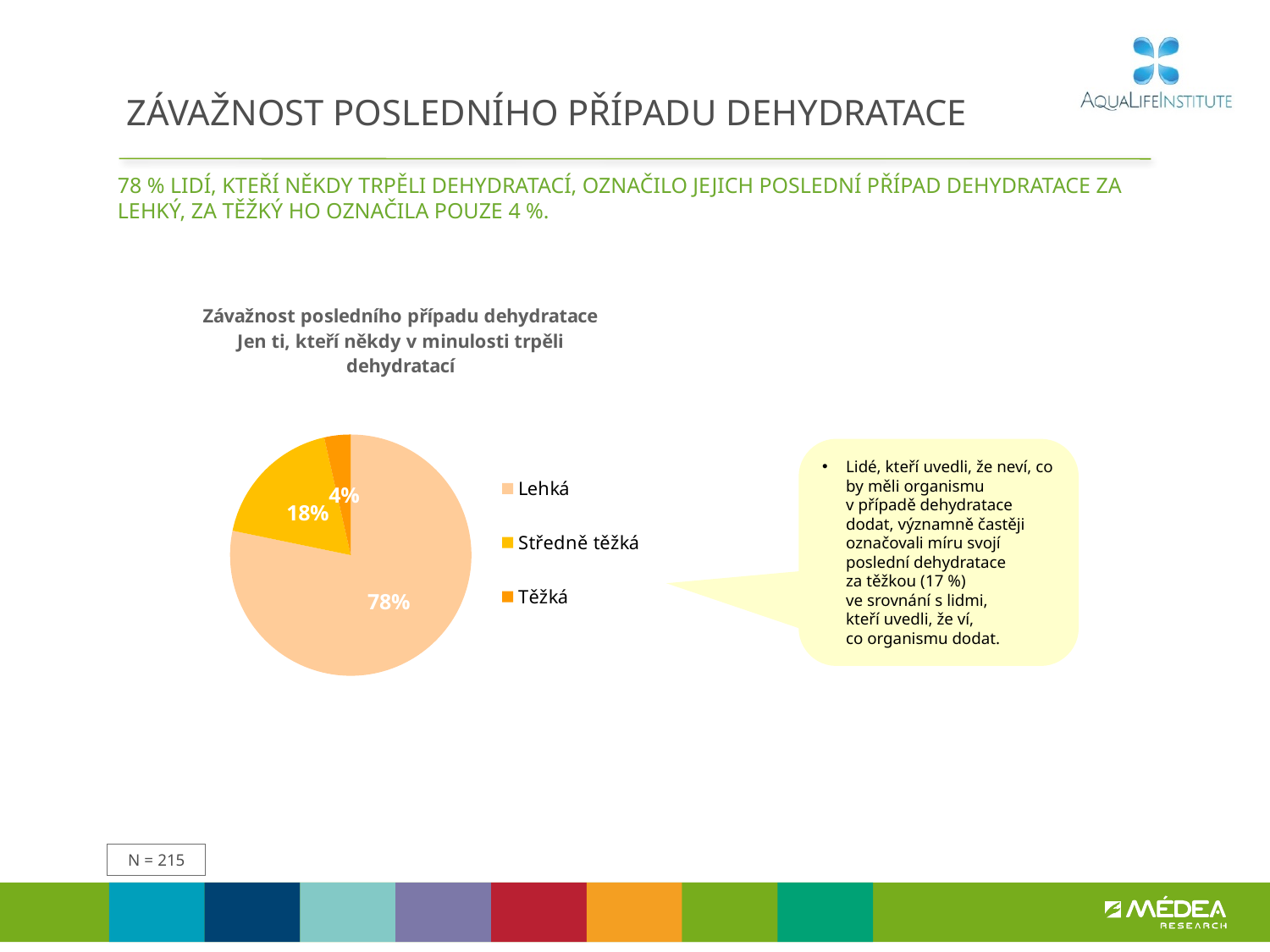
Which category has the smallest slice of the pie? Těžká How many categories does the pie chart show? 3 What sample size (N) is stated on the slide? N = 215 What is the first line of the chart's title? Závažnost posledního případu dehydratace Which category has the largest slice of the pie? Lehká What share of the pie does the "Lehká" slice represent? 78% Which slice is larger, "Středně těžká" or "Těžká"? Středně těžká What is the difference in percentage points between the "Středně těžká" and "Těžká" slices? 14 What type of chart is shown on the slide? pie chart What share of the pie does the "Středně těžká" slice represent? 18% What share of the pie does the "Těžká" slice represent? 4% What is the difference in percentage points between the "Lehká" and "Středně těžká" slices? 60